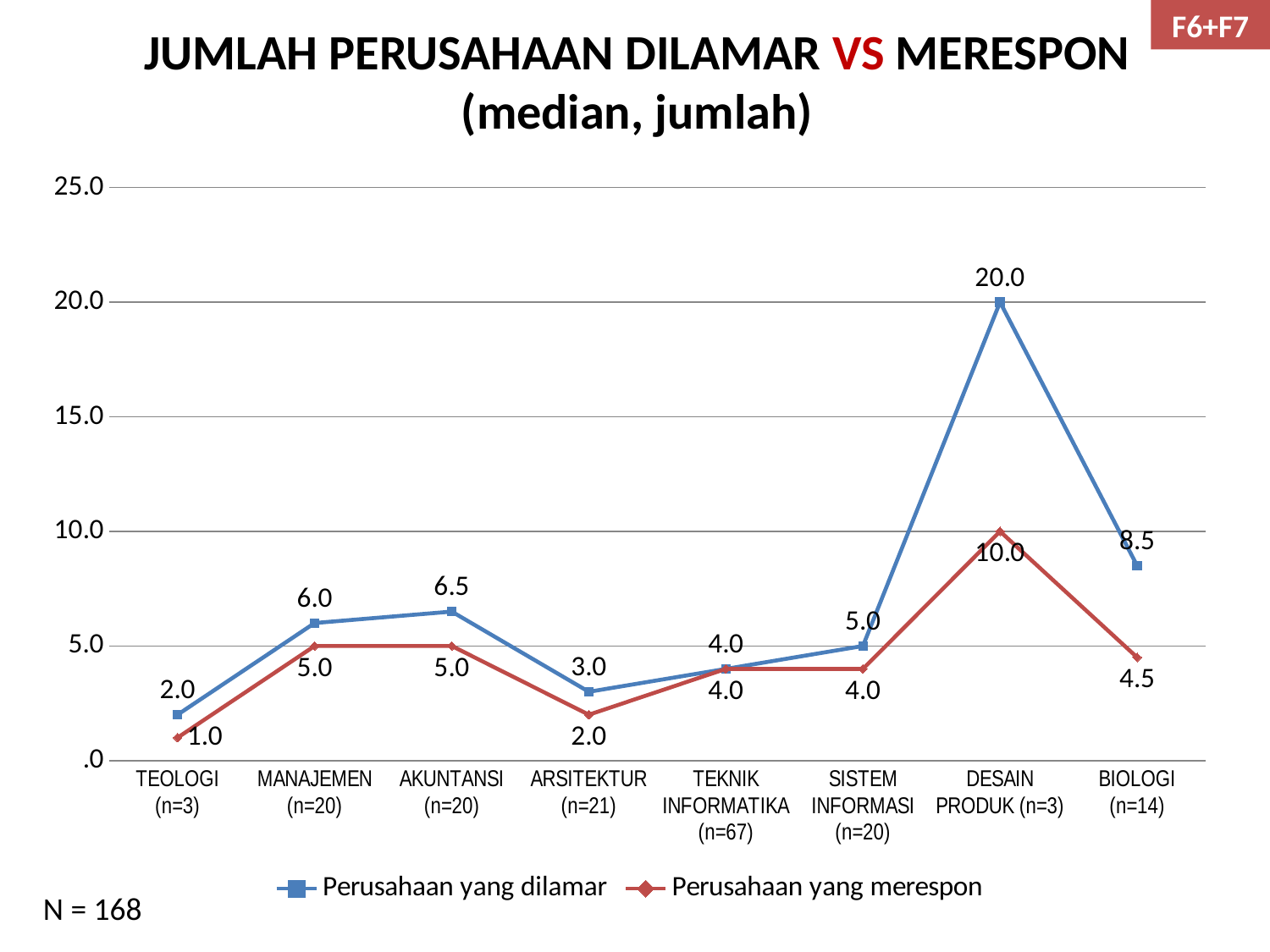
What is the difference between "Perusahaan yang dilamar" and "Perusahaan yang merespon" for DESAIN PRODUK (n=3)? 10.0 Which category has the highest value for "Perusahaan yang dilamar"? DESAIN PRODUK (n=3) What is the title of the chart? JUMLAH PERUSAHAAN DILAMAR VS MERESPON (median, jumlah) How many series does the legend list? 2 What is the value of "Perusahaan yang dilamar" for AKUNTANSI (n=20)? 6.5 What is the value of "Perusahaan yang merespon" for BIOLOGI (n=14)? 4.5 What kind of chart is shown on the slide? Line chart Which is larger for MANAJEMEN (n=20): "Perusahaan yang dilamar" or "Perusahaan yang merespon"? Perusahaan yang dilamar What is the difference between "Perusahaan yang dilamar" and "Perusahaan yang merespon" for BIOLOGI (n=14)? 4.0 What is the value of "Perusahaan yang dilamar" for DESAIN PRODUK (n=3)? 20.0 Which category has the lowest value for "Perusahaan yang merespon"? TEOLOGI (n=3) How many categories are shown on the x axis? 8